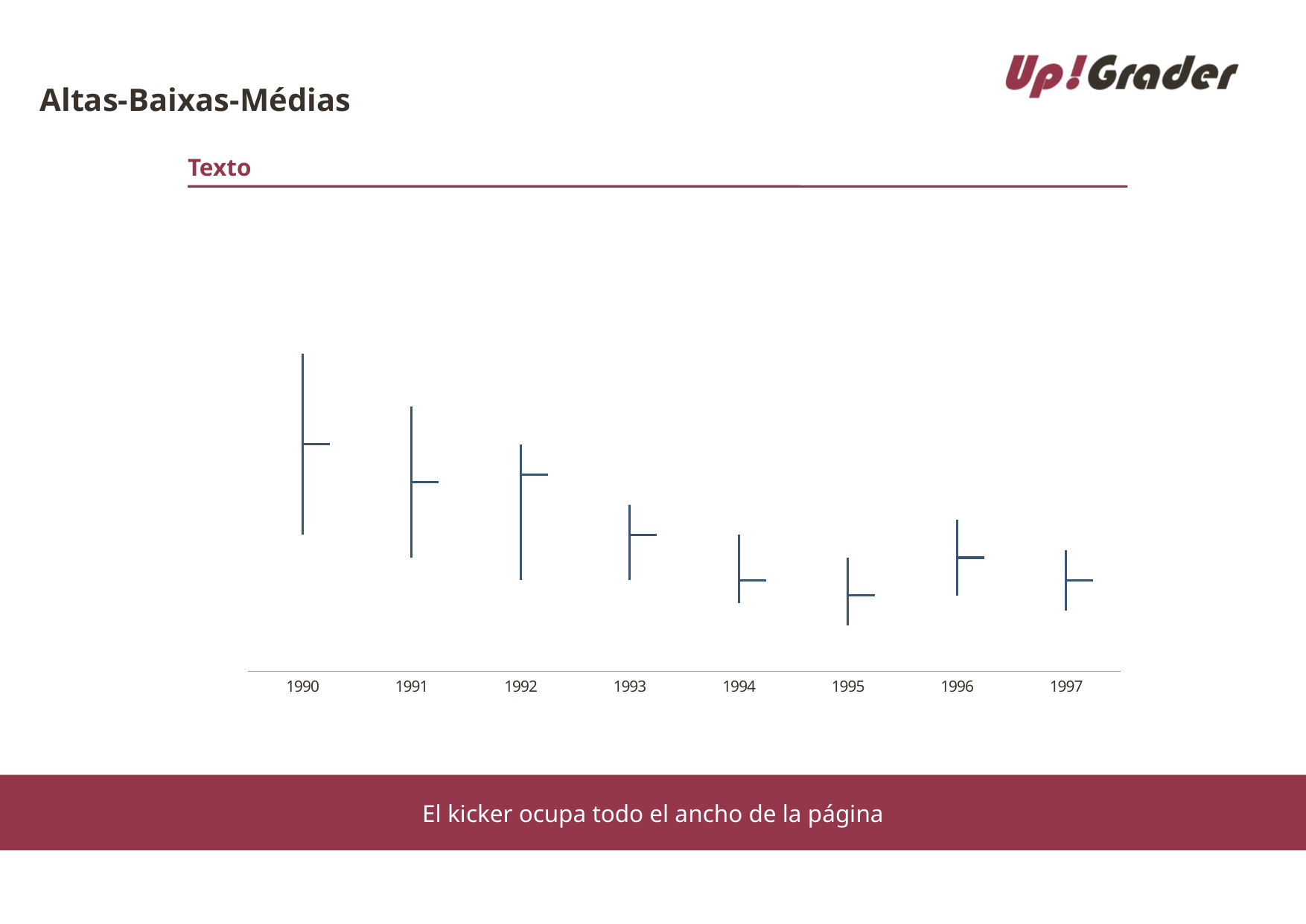
What is the first year shown on the x axis? 1990 Which year has the lowest low value in the chart? 1995 Which year has the longest high-low range in the chart? 1990 Do the values in the chart generally rise or fall from 1990 to 1997? fall Which year has the highest high value in the chart? 1990 What is the last year shown on the x axis? 1997 Which year has the larger high value, 1991 or 1994? 1991 How many years are shown on the x axis of the chart? 8 What kind of chart is shown on the slide? stock chart (high-low-close) Which year has the larger close marker value, 1990 or 1997? 1990 Which year has the larger close marker value, 1995 or 1996? 1996